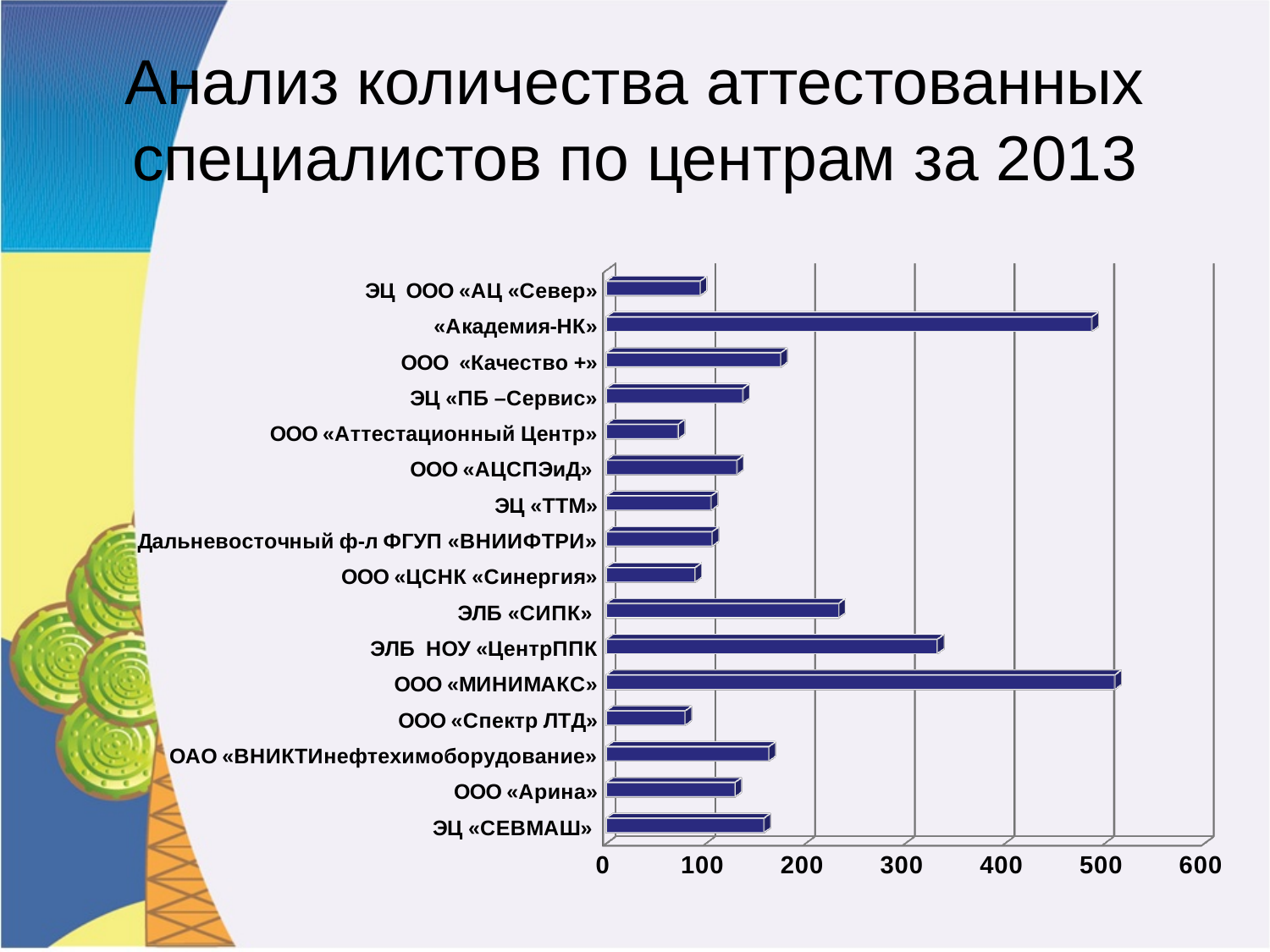
Is the value for ЭЛБ НОУ «ЦентрППК» greater or less than 300? greater Is the value for ООО «Качество +» greater or less than 100? greater Is the value for ЭЛБ «СИПК» greater or less than 200? greater Which is larger, the value for «Академия-НК» or the value for ЭЦ ООО «АЦ «Север»? «Академия-НК» What is the title of the slide containing the chart? Анализ количества аттестованных специалистов по центрам за 2013 How many centres (categories) are plotted in the chart? 16 Which is larger, the value for ЭЛБ НОУ «ЦентрППК» or the value for ЭЛБ «СИПК»? ЭЛБ НОУ «ЦентрППК» Which centre has the highest number of certified specialists in the chart? ООО «МИНИМАКС» What kind of chart is shown on the slide? bar chart